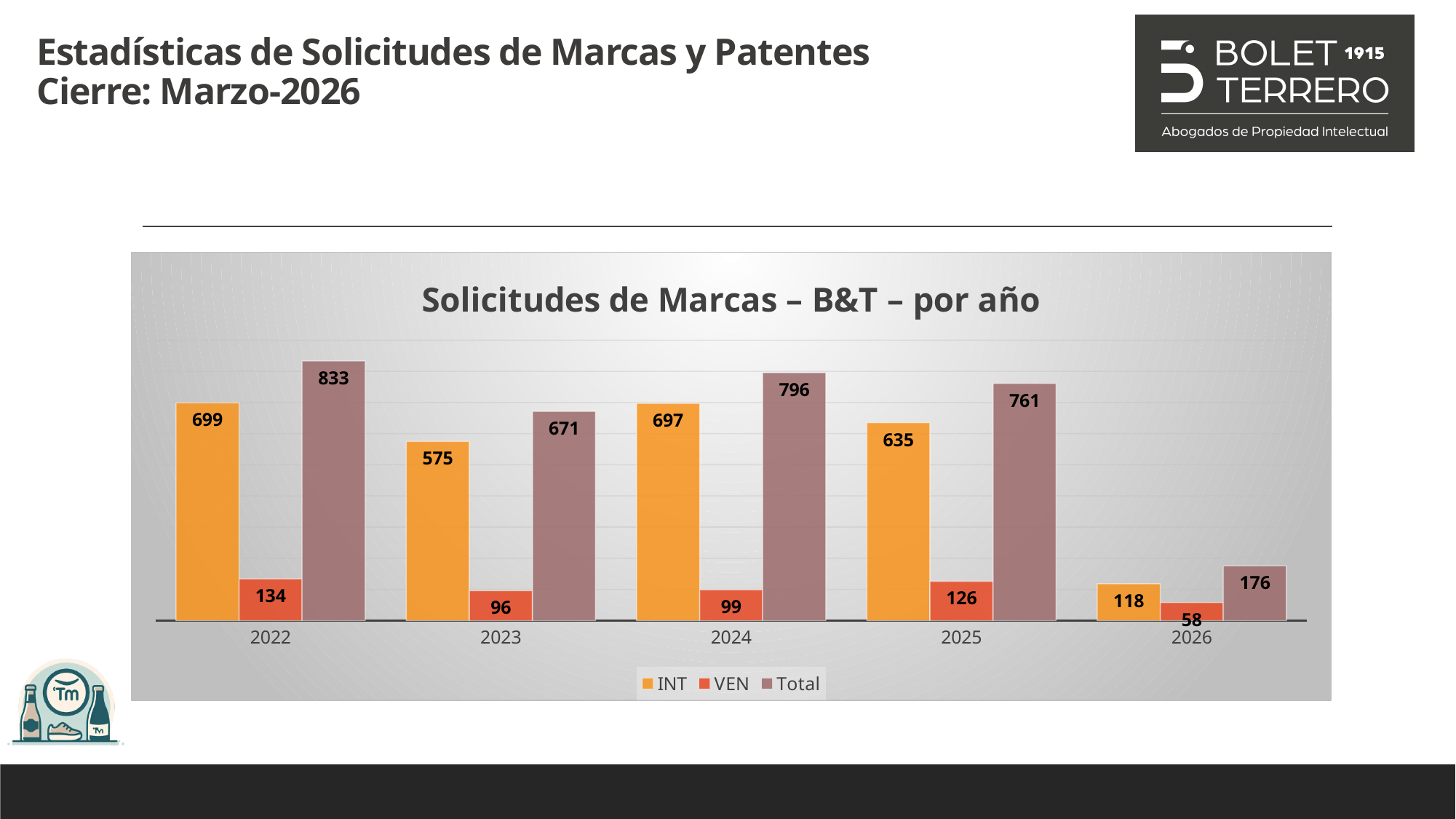
Which year has the highest Total value? 2022 Which year has the lowest INT value? 2026 What is the VEN value for 2026? 58 What is the Total value for 2024? 796 What is the VEN value for 2023? 96 What is the title of the chart? Solicitudes de Marcas – B&T – por año What is the difference between the Total values for 2022 and 2023? 162 How many series does the legend list? 3 Which is larger, the VEN value for 2022 or the VEN value for 2025? 2022 How many years are shown on the x axis? 5 What kind of chart is shown? Bar chart What is the INT value for 2022? 699